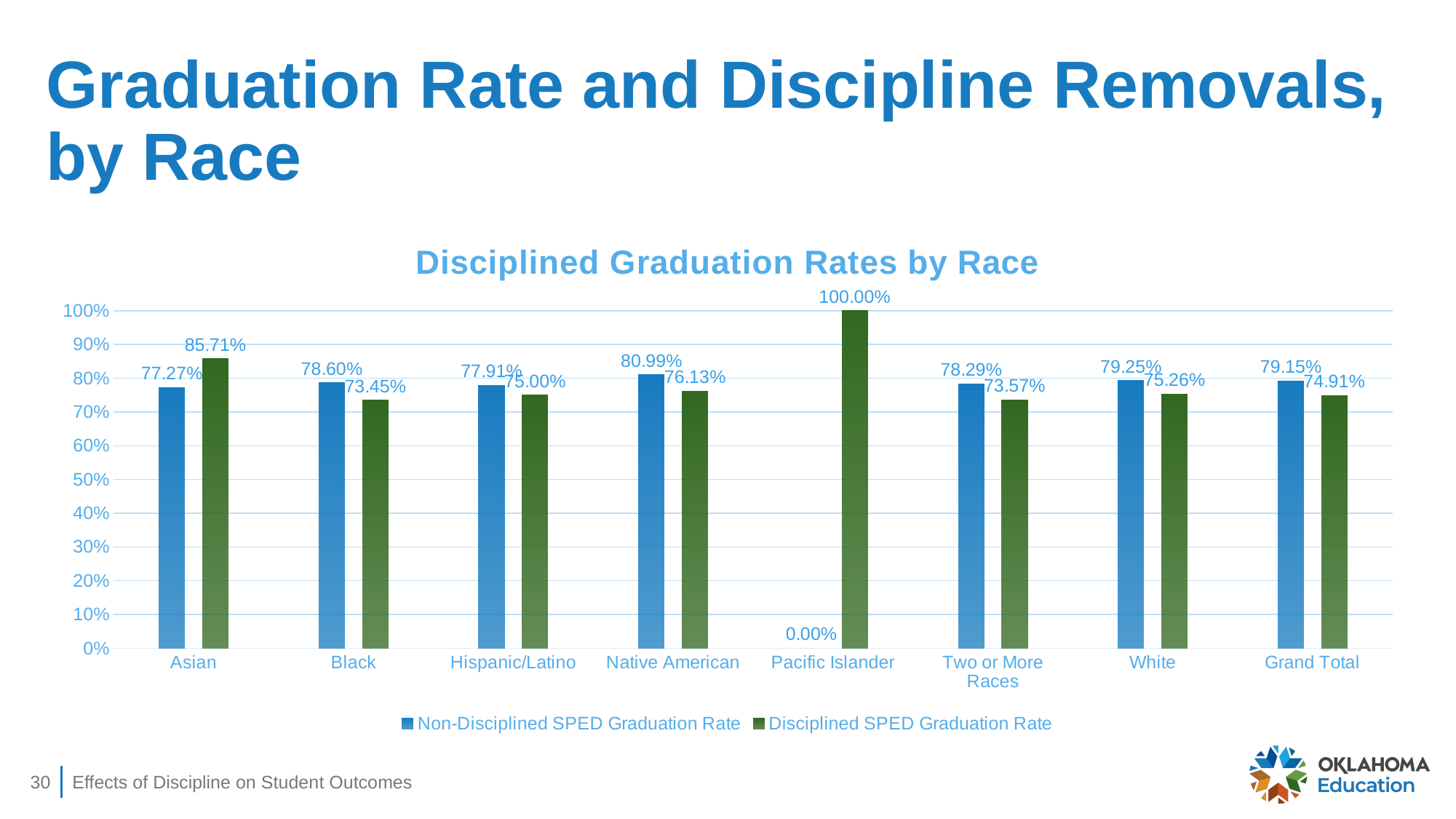
What is the Disciplined SPED Graduation Rate for Asian students? 85.71% Which category has the lowest Non-Disciplined SPED Graduation Rate? Pacific Islander For Black students, how much higher is the Non-Disciplined SPED Graduation Rate than the Disciplined SPED Graduation Rate? 5.15% For Asian students, which is larger: the Non-Disciplined or the Disciplined SPED Graduation Rate? Disciplined SPED Graduation Rate How many categories are shown on the x axis of the chart? 8 What kind of chart is shown on the slide? Bar chart What is the Disciplined SPED Graduation Rate for the Grand Total category? 74.91% For Native American students, what is the difference between the Non-Disciplined and Disciplined SPED Graduation Rates? 4.86% How many series does the chart's legend list? 2 Which category has the highest Disciplined SPED Graduation Rate? Pacific Islander What is the Non-Disciplined SPED Graduation Rate for Native American students? 80.99% What is the title of the chart? Disciplined Graduation Rates by Race